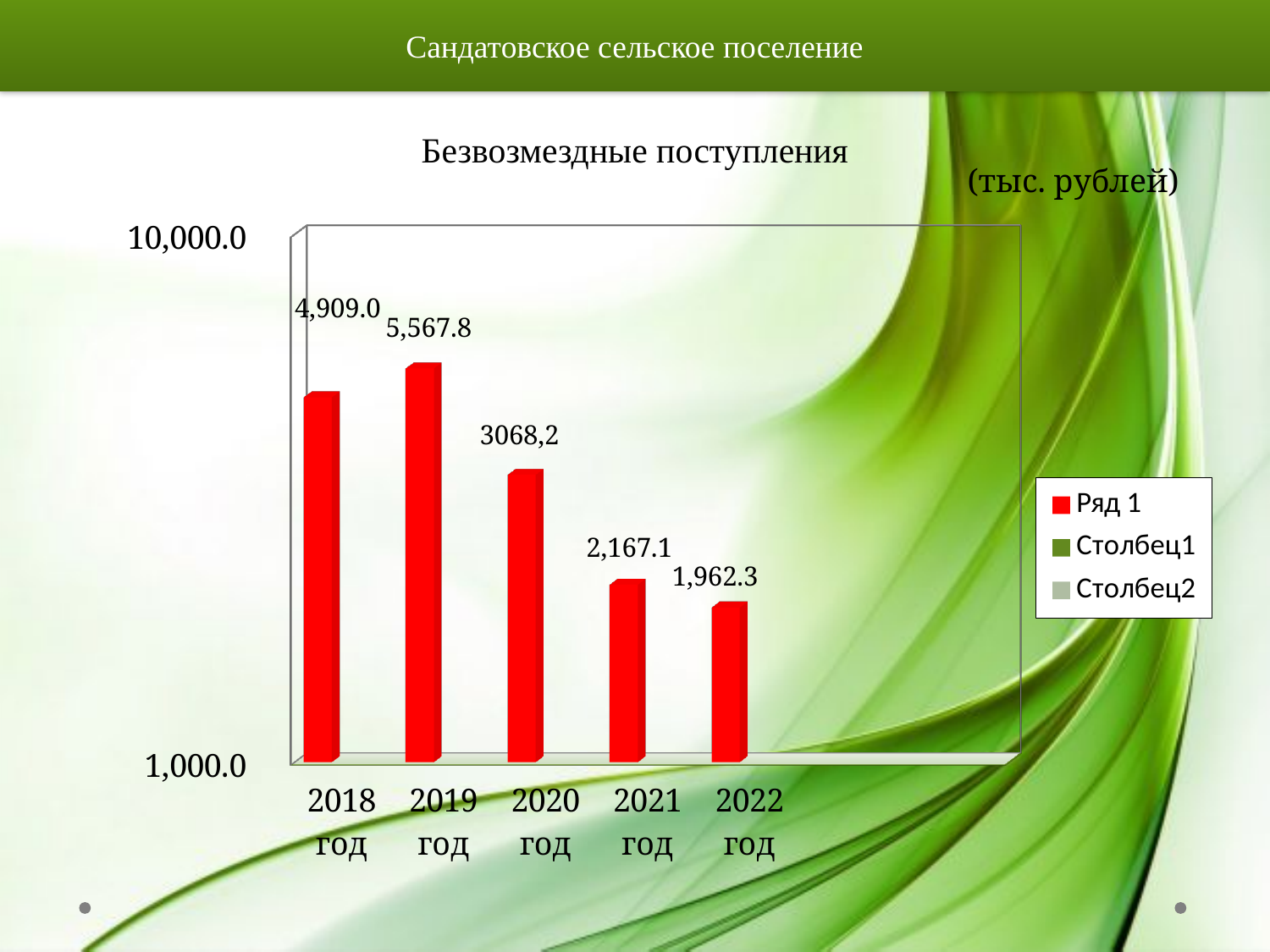
Which year has the highest value in the Безвозмездные поступления chart? 2019 год How many entries does the legend of the Безвозмездные поступления chart list? 3 What is the value for 2018 год in the Безвозмездные поступления chart? 4,909.0 What type of chart is the Безвозмездные поступления chart? Bar chart What is the difference between the values for 2021 год and 2022 год in the Безвозмездные поступления chart? 204.8 Which year has the lowest value in the Безвозмездные поступления chart? 2022 год Which is larger in the Безвозмездные поступления chart, the value for 2018 год or the value for 2020 год? 2018 год What is the difference between the values for 2019 год and 2018 год in the Безвозмездные поступления chart? 658.8 What is the value for 2019 год in the Безвозмездные поступления chart? 5,567.8 How many years are shown on the x axis of the Безвозмездные поступления chart? 5 What is the value for 2022 год in the Безвозмездные поступления chart? 1,962.3 What is the value for 2020 год in the Безвозмездные поступления chart? 3068,2